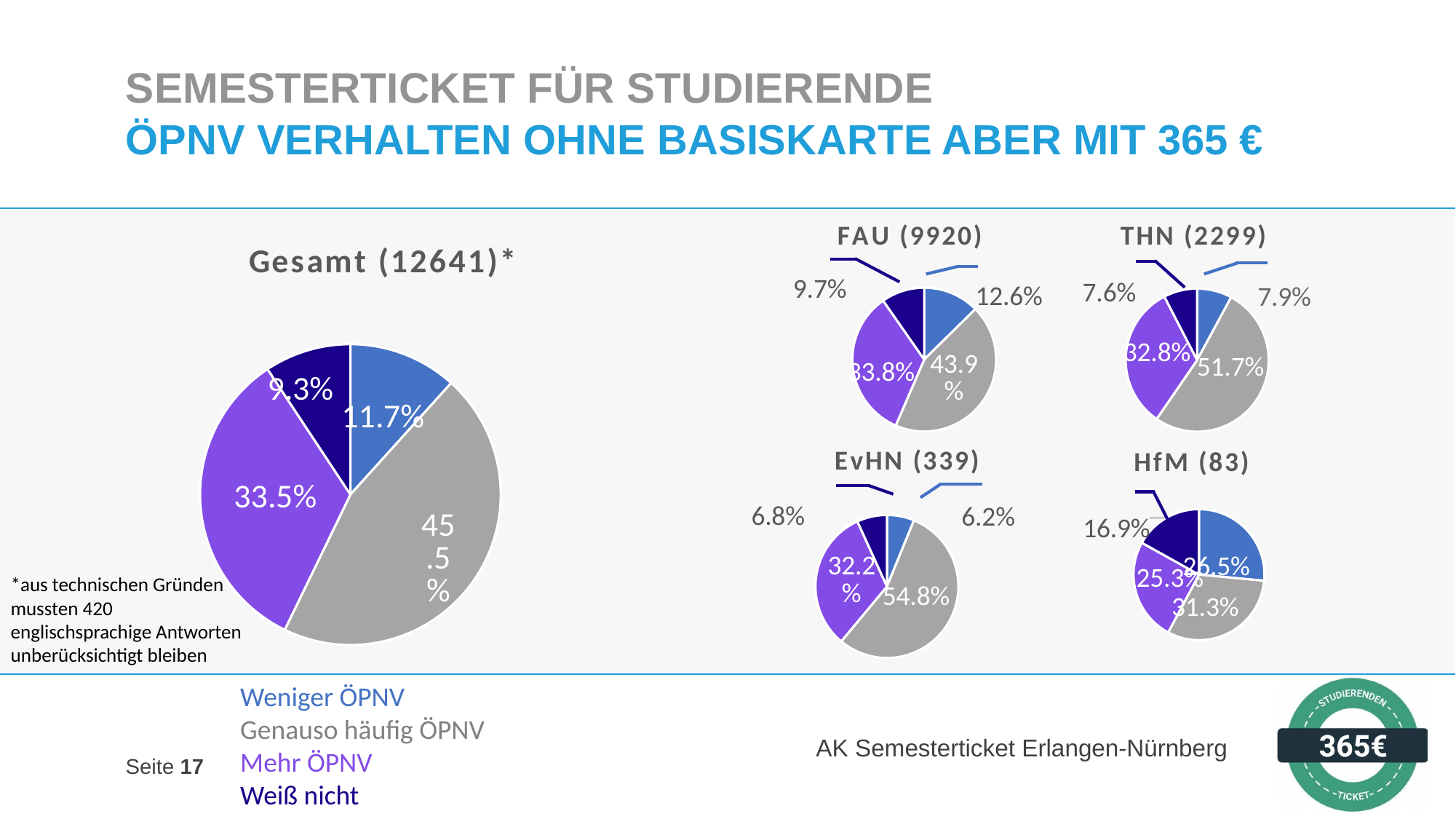
In the 'THN (2299)' pie chart, what is the difference between the 'Genauso häufig ÖPNV' share (51.7%) and the 'Mehr ÖPNV' share (32.8%)? 18.9% In the 'HfM (83)' pie chart, which is larger: the 'Weniger ÖPNV' slice or the 'Mehr ÖPNV' slice? Weniger ÖPNV How many categories does the legend at the bottom of the slide list? 4 In the 'EvHN (339)' pie chart, which category has the smallest slice? Weniger ÖPNV In the 'FAU (9920)' pie chart, what share is labelled for the 'Weniger ÖPNV' (blue) slice? 12.6% In the 'THN (2299)' pie chart, which category has the largest slice? Genauso häufig ÖPNV Which legend category is shown in purple? Mehr ÖPNV What kind of charts are shown on the slide? Pie charts In the 'Gesamt (12641)*' pie chart, what share is labelled for the 'Mehr ÖPNV' (purple) slice? 33.5% In the 'HfM (83)' pie chart, what share is labelled for the 'Weiß nicht' (dark blue) slice? 16.9% How many pie charts are on the slide? 5